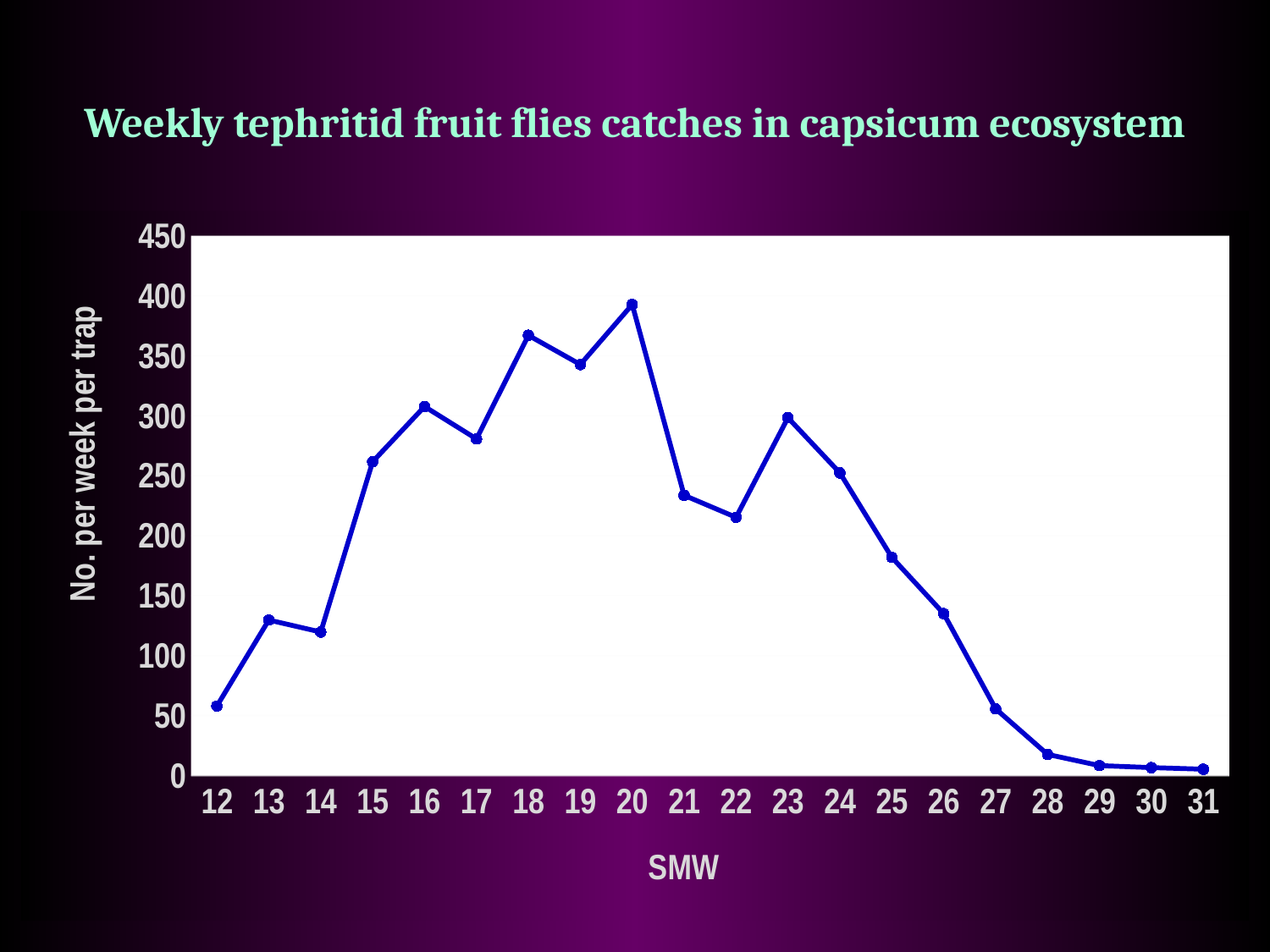
Is the value for SMW 25 greater or less than 200? less How many SMW data points are plotted on the chart? 20 At which SMW is the number of fruit flies per week per trap highest? 20 What is the label on the y axis of the chart? No. per week per trap Is the value for SMW 12 greater or less than 100? less Which has a higher value, SMW 16 or SMW 22? SMW 16 Which has a higher value, SMW 20 or SMW 23? SMW 20 Do the values rise or fall from SMW 23 to SMW 31? fall What kind of chart is shown on the slide? Line chart Is the value for SMW 26 greater or less than 150? less